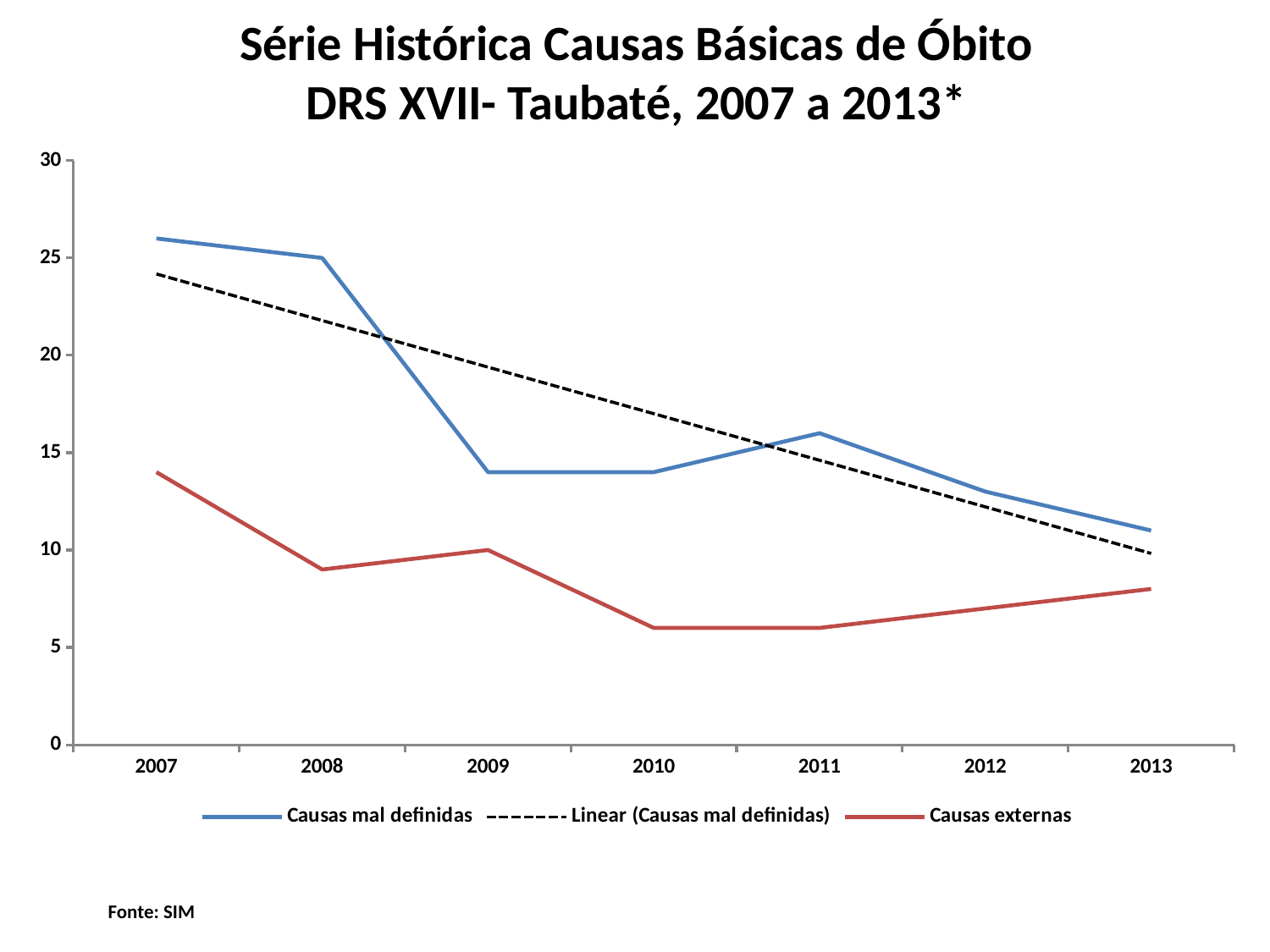
Do the values for Causas mal definidas generally rise or fall from 2007 to 2013? fall What is the source cited below the chart? SIM How many series does the legend list? 3 In which year is the value for Causas externas highest? 2007 In which year is the value for Causas mal definidas highest? 2007 Is the value for Causas externas in 2010 greater or less than 10? less Is the value for Causas mal definidas in 2011 greater or less than 15? greater Which series has the larger value in 2013, Causas mal definidas or Causas externas? Causas mal definidas How many years are shown on the x axis? 7 Is the value for Causas mal definidas in 2007 greater or less than 25? greater In which year is the value for Causas mal definidas lowest? 2013 What kind of chart is shown on the slide? line chart